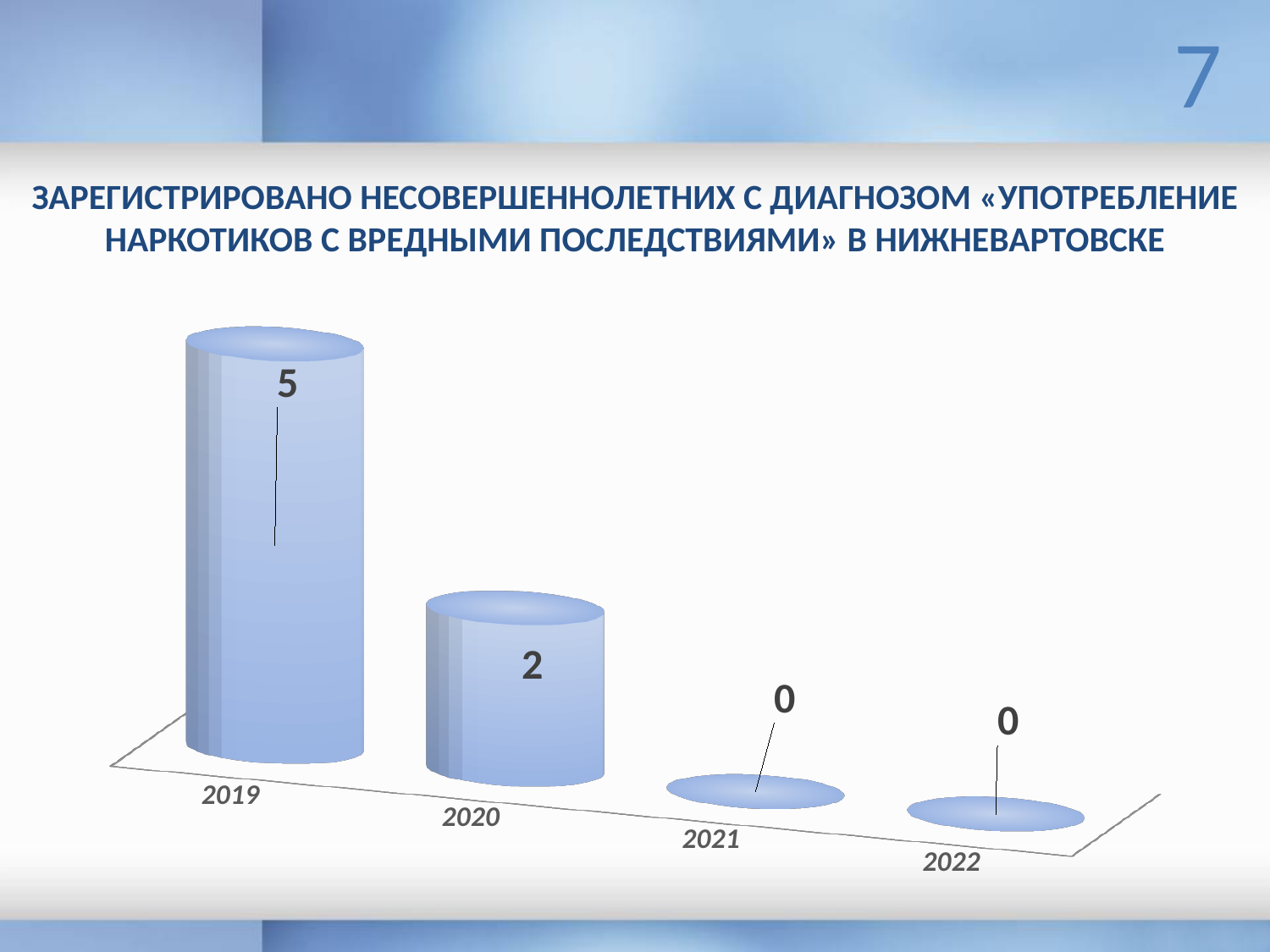
What is the value for 2020? 2 Which is larger, the value for 2019 or the value for 2020? 2019 Do the values rise or fall from 2019 to 2022? fall What is the value for 2021? 0 What kind of chart is shown on the slide? bar chart Which city is named in the chart title? Нижневартовск What is the value for 2022? 0 How many years are shown on the chart? 4 What is the difference between the values for 2019 and 2020? 3 What is the value for 2019? 5 What is the total of the values for all four years? 7 Which year has the highest value? 2019